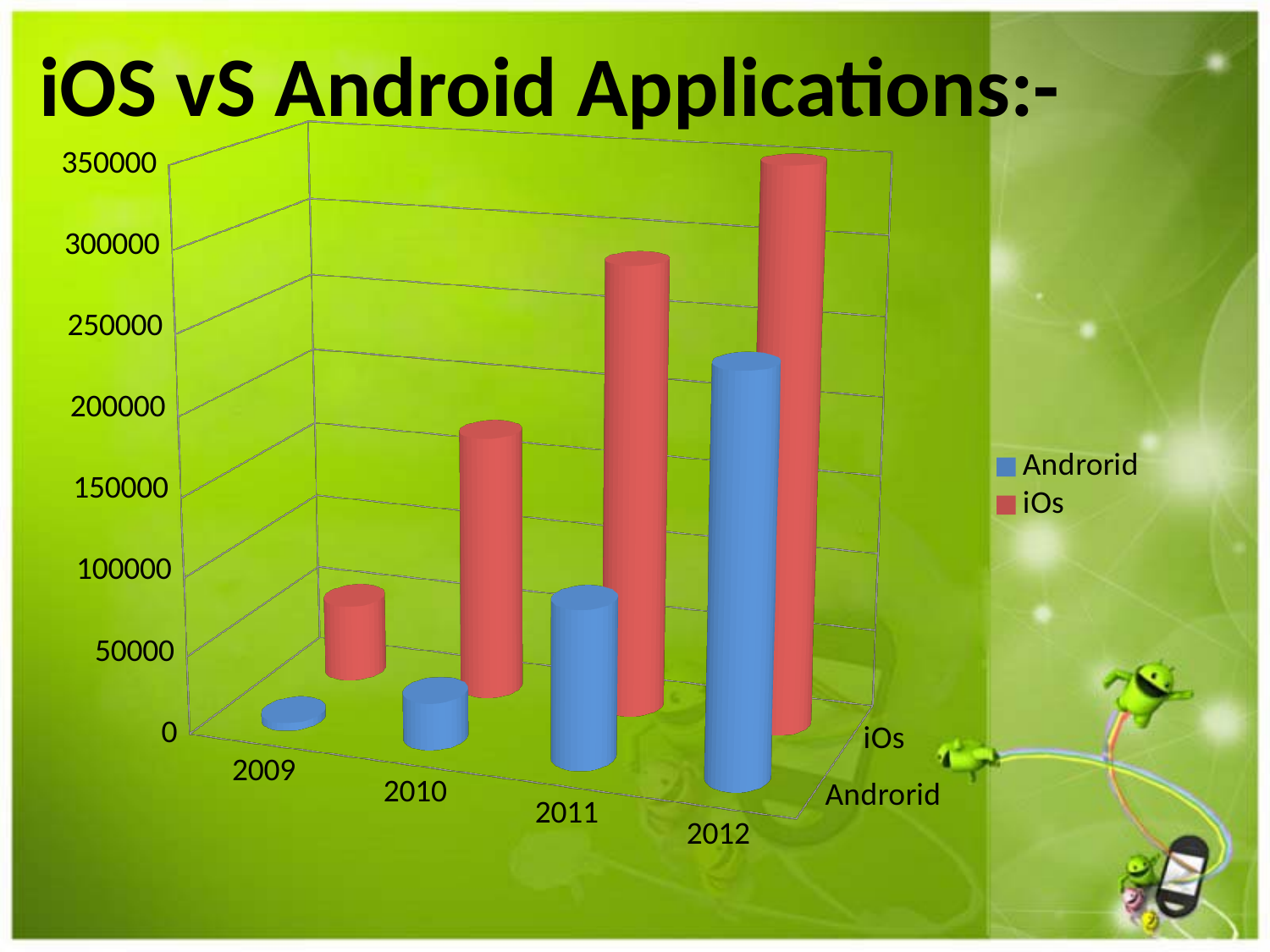
Do the Androrid values rise or fall from 2009 to 2012? rise What kind of chart is shown on the slide? bar chart How many series does the legend list? 2 How many years are shown on the x axis? 4 In 2011, which series has the larger value, Androrid or iOs? iOs Which year has the highest value for the iOs series? 2012 Is the value for iOs in 2012 greater or less than 250000? greater Is the value for iOs in 2009 greater or less than 150000? less What colour represents the iOs series in the chart? red Is the value for Androrid in 2009 greater or less than 50000? less Which year has the lowest value for the Androrid series? 2009